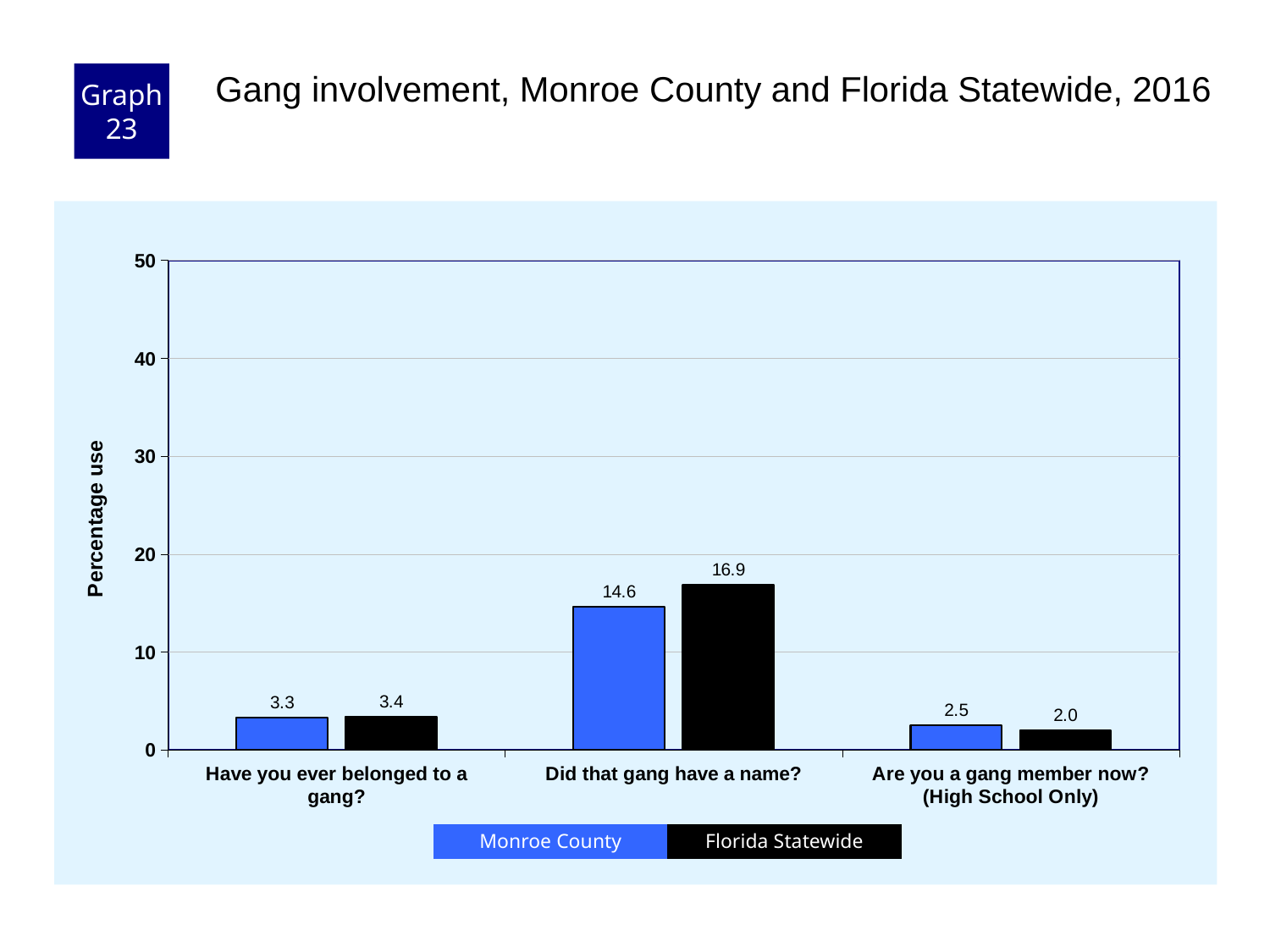
How many questions (categories) are shown on the x axis? 3 What is the Monroe County value for "Did that gang have a name?"? 14.6 For "Are you a gang member now? (High School Only)", which is larger: Monroe County or Florida Statewide? Monroe County What is the Monroe County value for "Are you a gang member now? (High School Only)"? 2.5 How many series does the legend list? 2 Which question has the lowest Monroe County value? Are you a gang member now? (High School Only) Which question has the highest Florida Statewide value? Did that gang have a name? Is the Florida Statewide value for "Did that gang have a name?" greater or less than 20? less What kind of chart is shown on the slide? Bar chart What is the Florida Statewide value for "Have you ever belonged to a gang?"? 3.4 What is the difference between the Florida Statewide and Monroe County values for "Did that gang have a name?"? 2.3 What is the label of the y axis? Percentage use